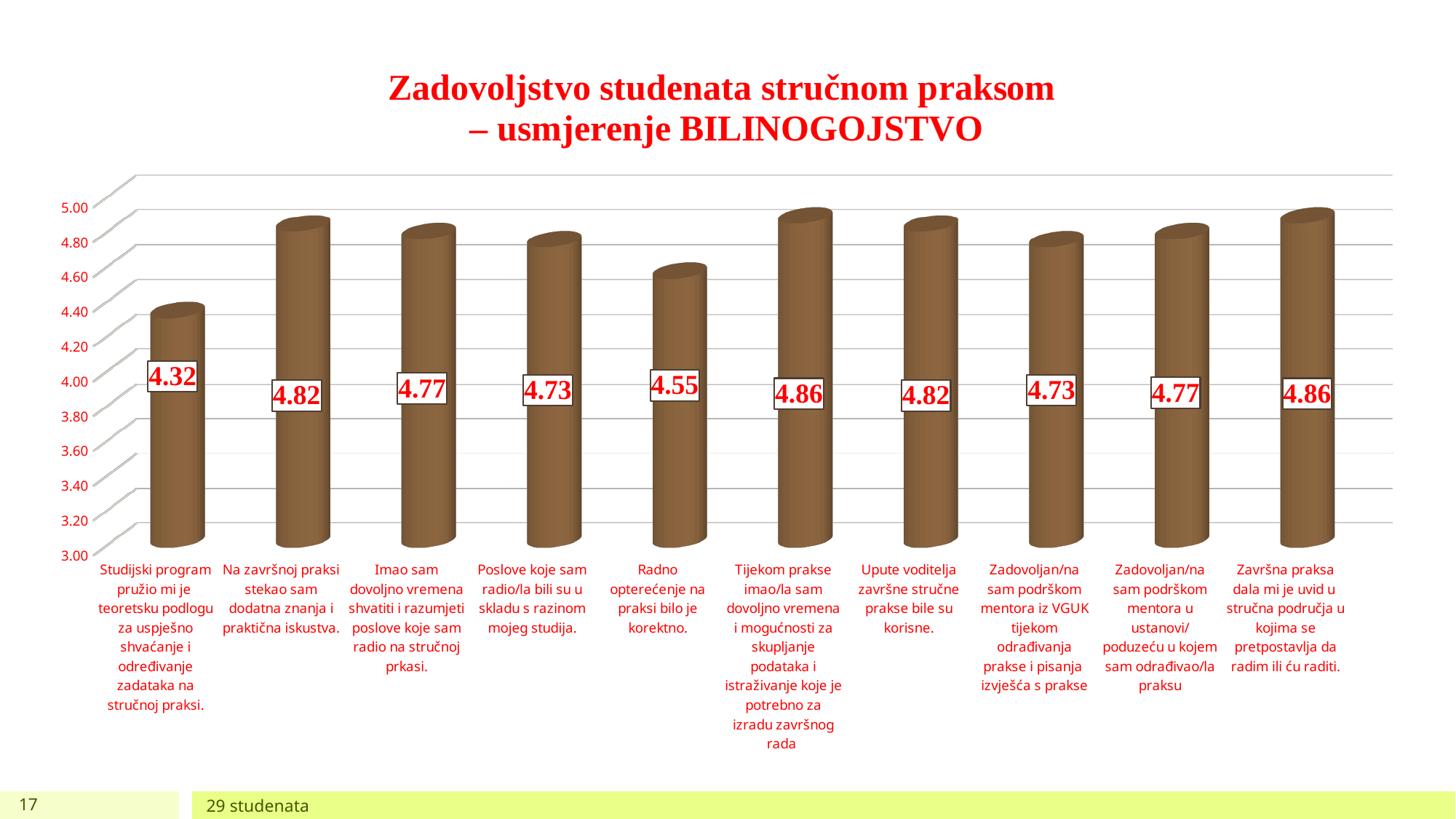
What is the value for "Radno opterećenje na praksi bilo je korektno."? 4.55 What is the title of the chart? Zadovoljstvo studenata stručnom praksom – usmjerenje BILINOGOJSTVO What is the highest value shown in the chart? 4.86 What is the lowest value shown in the chart? 4.32 What kind of chart is shown on the slide? Bar chart What is the difference between the value for "Na završnoj praksi stekao sam dodatna znanja i praktična iskustva." and the value for "Radno opterećenje na praksi bilo je korektno."? 0.27 What is the value for "Poslove koje sam radio/la bili su u skladu s razinom mojeg studija."? 4.73 Which category has the lowest value? Studijski program pružio mi je teoretsku podlogu za uspješno shvaćanje i određivanje zadataka na stručnoj praksi. What is the difference between the value for "Završna praksa dala mi je uvid u stručna područja u kojima se pretpostavlja da radim ili ću raditi." and the value for "Studijski program pružio mi je teoretsku podlogu za uspješno shvaćanje i određivanje zadataka na stručnoj praksi."? 0.54 Which is larger: the value for "Imao sam dovoljno vremena shvatiti i razumjeti poslove koje sam radio na stručnoj prkasi." or the value for "Radno opterećenje na praksi bilo je korektno."? Imao sam dovoljno vremena shvatiti i razumjeti poslove koje sam radio na stručnoj prkasi. How many categories are shown in the chart? 10 What is the value for "Upute voditelja završne stručne prakse bile su korisne."? 4.82